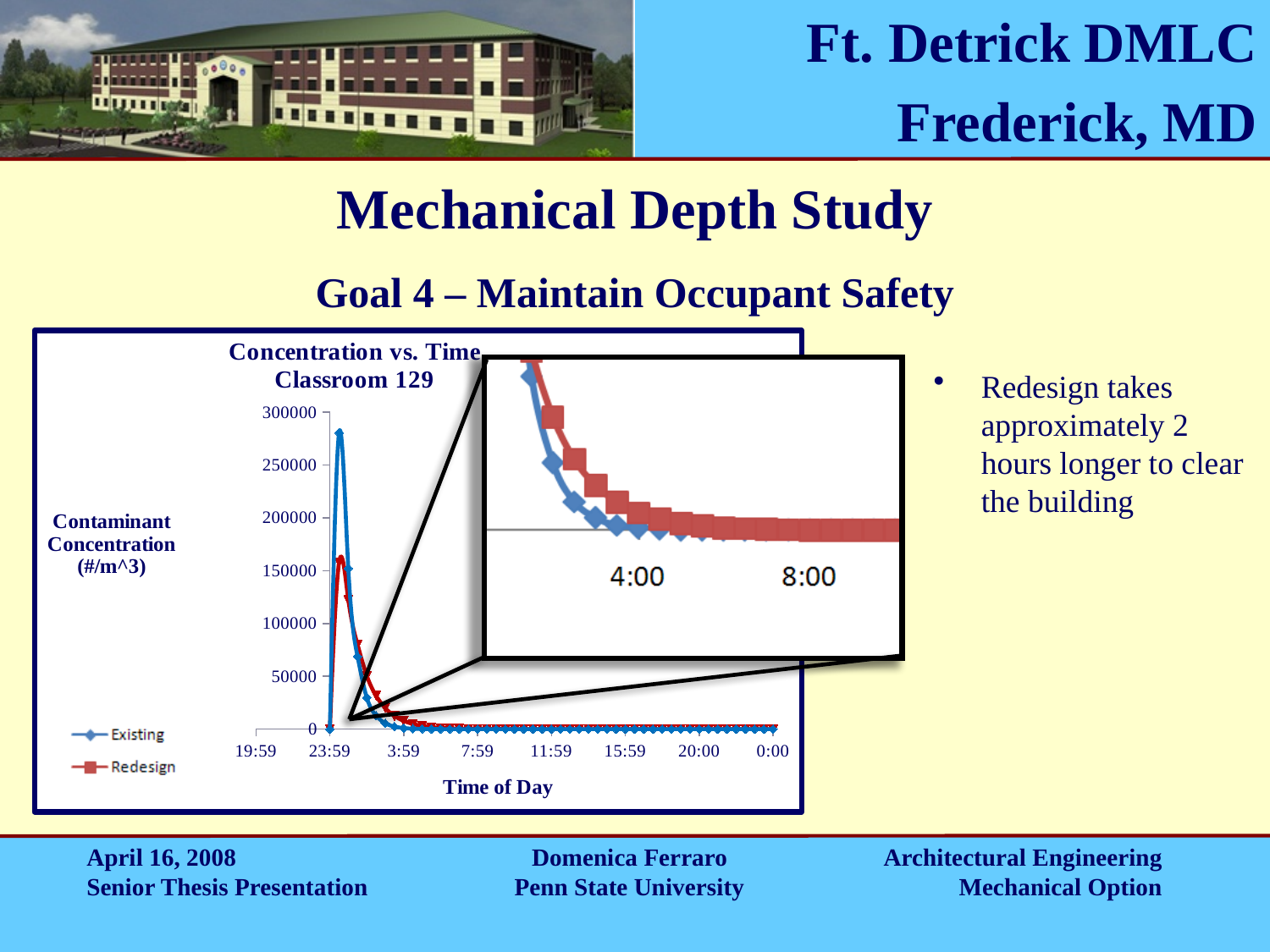
What are the two series named in the legend of the chart? Existing and Redesign Is the peak value of the Existing series greater or less than 250000? greater What is the title of the chart? Concentration vs. Time Classroom 129 Is the peak value of the Redesign series greater or less than 100000? greater How many series does the legend of the Concentration vs. Time chart list? 2 How many time labels are shown along the x axis of the chart? 8 After the peak near 23:59, do the concentration values rise or fall as time moves along the x axis? fall Which series reaches the higher peak concentration, Existing or Redesign? Existing Is the peak value of the Redesign series greater or less than 200000? less Which series has the lower peak concentration? Redesign What is the highest value labelled on the y axis of the chart? 300000 What kind of chart is shown on the slide? line chart